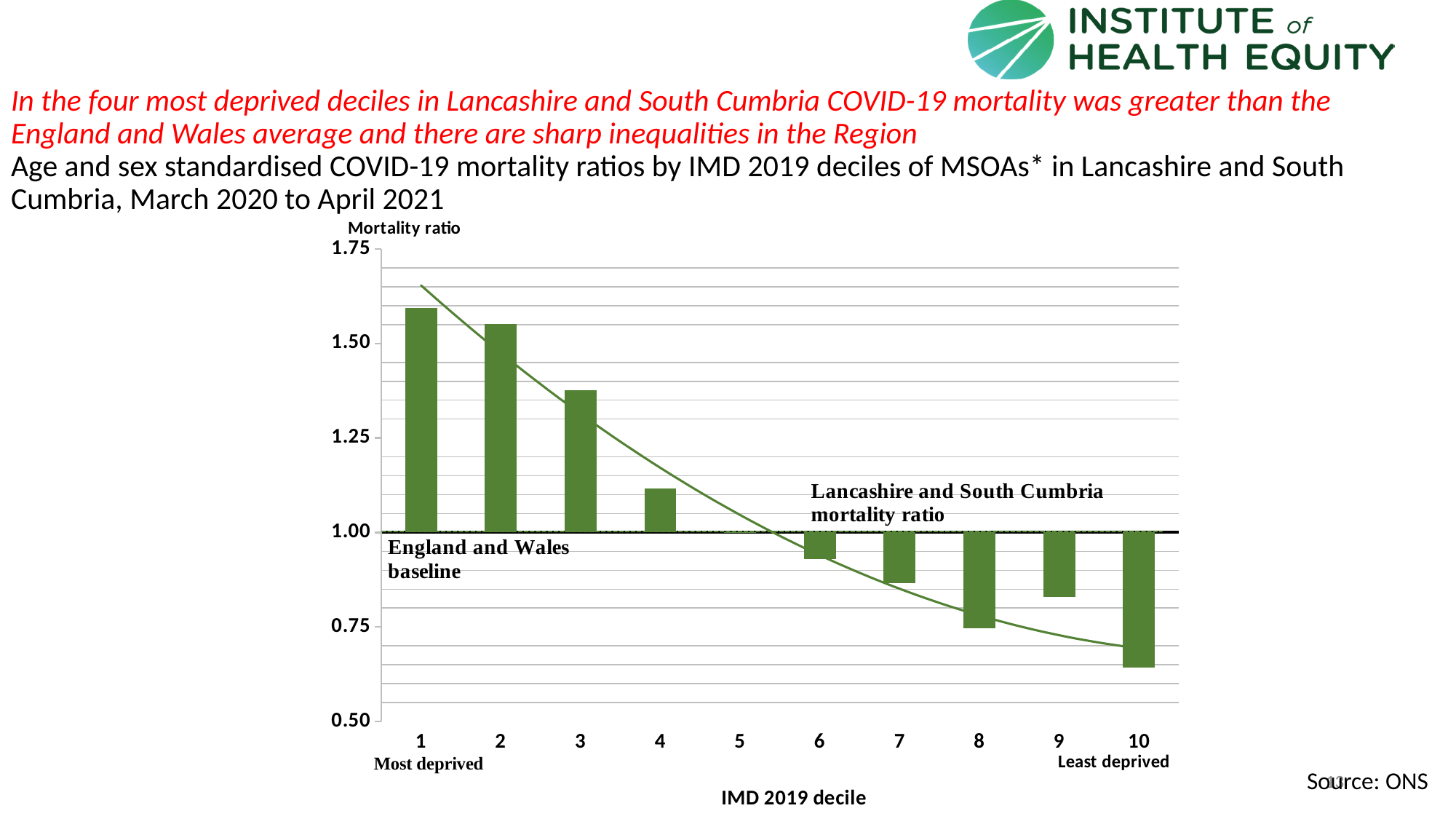
What kind of chart is shown on the slide? Bar chart Which IMD decile has the lowest mortality ratio? 10 What is the title of the x axis? IMD 2019 decile Is the mortality ratio for decile 1 greater or less than 1.50? greater Do the mortality ratios generally rise or fall from decile 1 to decile 10? Fall Which has the higher mortality ratio, decile 3 or decile 4? Decile 3 At what mortality ratio value is the England and Wales baseline drawn? 1.00 Is the mortality ratio for decile 3 greater or less than 1.25? greater Is the mortality ratio for decile 10 greater or less than 0.75? less How many IMD 2019 deciles are shown on the x axis? 10